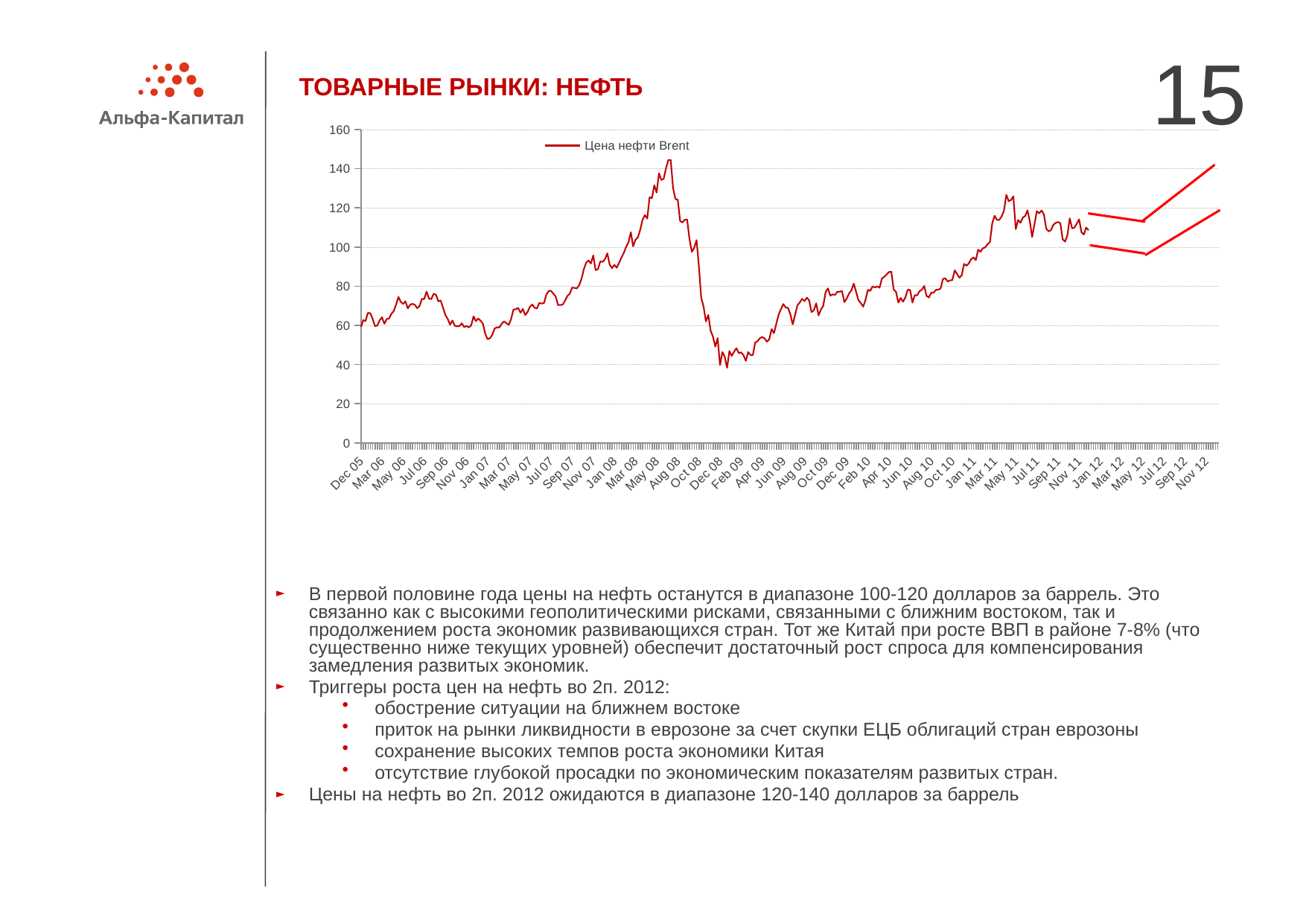
Does the Brent oil price rise or fall between Feb 09 and Mar 11? rise What kind of chart is shown on the slide? line chart What is the name of the series shown in the chart legend? Цена нефти Brent Does the Brent oil price rise or fall between Aug 08 and Dec 08? fall Is the value of the Brent oil price at its low point around the turn of 2008/2009 greater or less than 60? less What is the title of the slide containing the chart? ТОВАРНЫЕ РЫНКИ: НЕФТЬ What is the highest value shown on the vertical axis of the chart? 160 In which year does the Brent oil price line reach its highest point? 2008 Is the value of the Brent oil price at its peak in mid-2008 greater or less than 120? greater Is the value of the Brent oil price at the start of the chart (Dec 05) greater or less than 80? less How many series does the chart legend list? 1